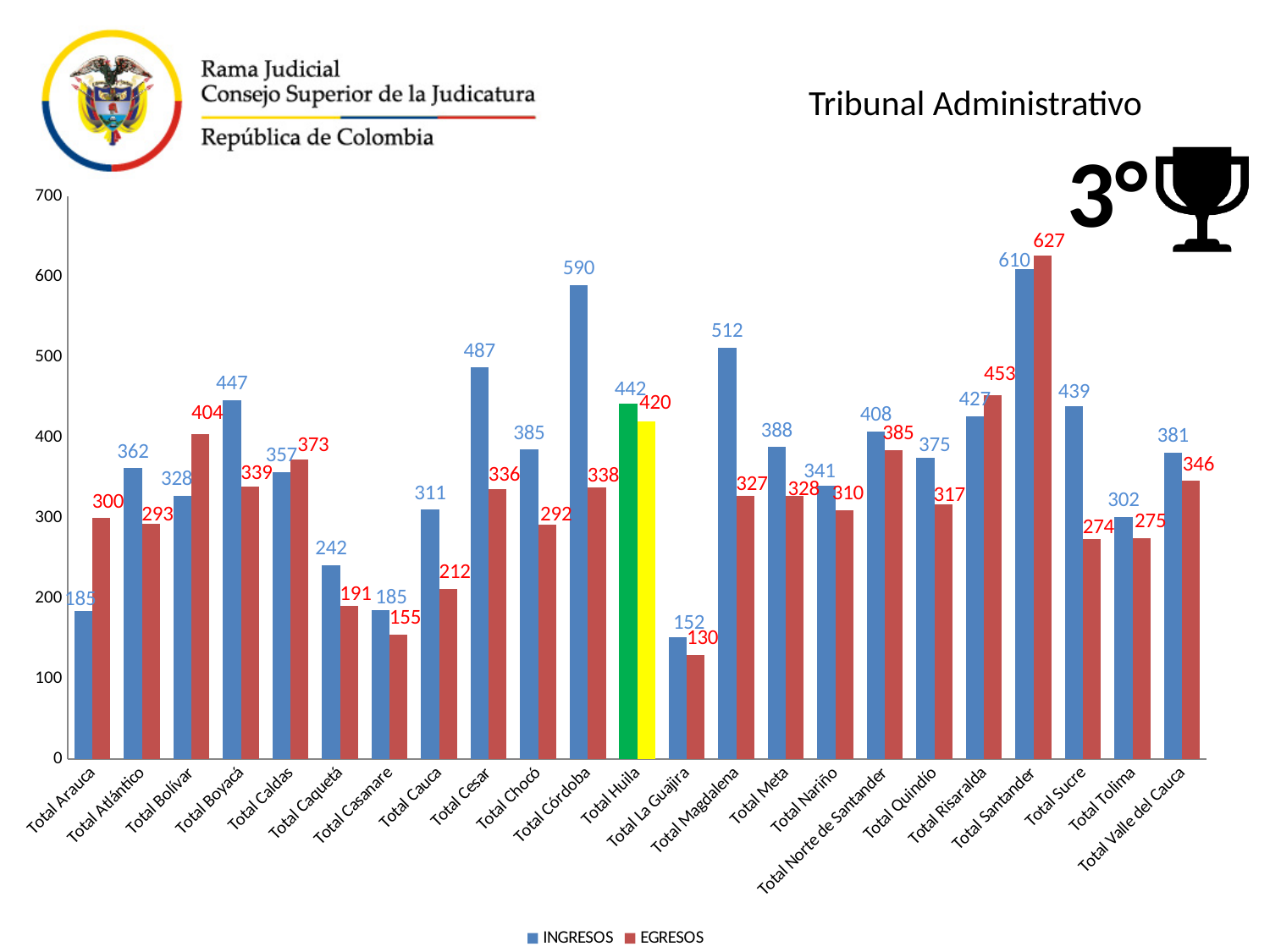
What is the EGRESOS value for Total Bolívar? 404 Which category has the highest EGRESOS value? Total Santander Which category has the lowest INGRESOS value? Total La Guajira Which is larger for Total Risaralda, INGRESOS or EGRESOS? EGRESOS What kind of chart is shown on the slide? Bar chart Is the INGRESOS value for Total Magdalena greater or less than 500? greater How many categories are shown on the x axis? 23 What is the INGRESOS value for Total Córdoba? 590 What is the difference between the INGRESOS values for Total Santander and Total Sucre? 171 What is the INGRESOS value for Total Huila? 442 How many series does the legend list? 2 What is the difference between INGRESOS and EGRESOS for Total Córdoba? 252